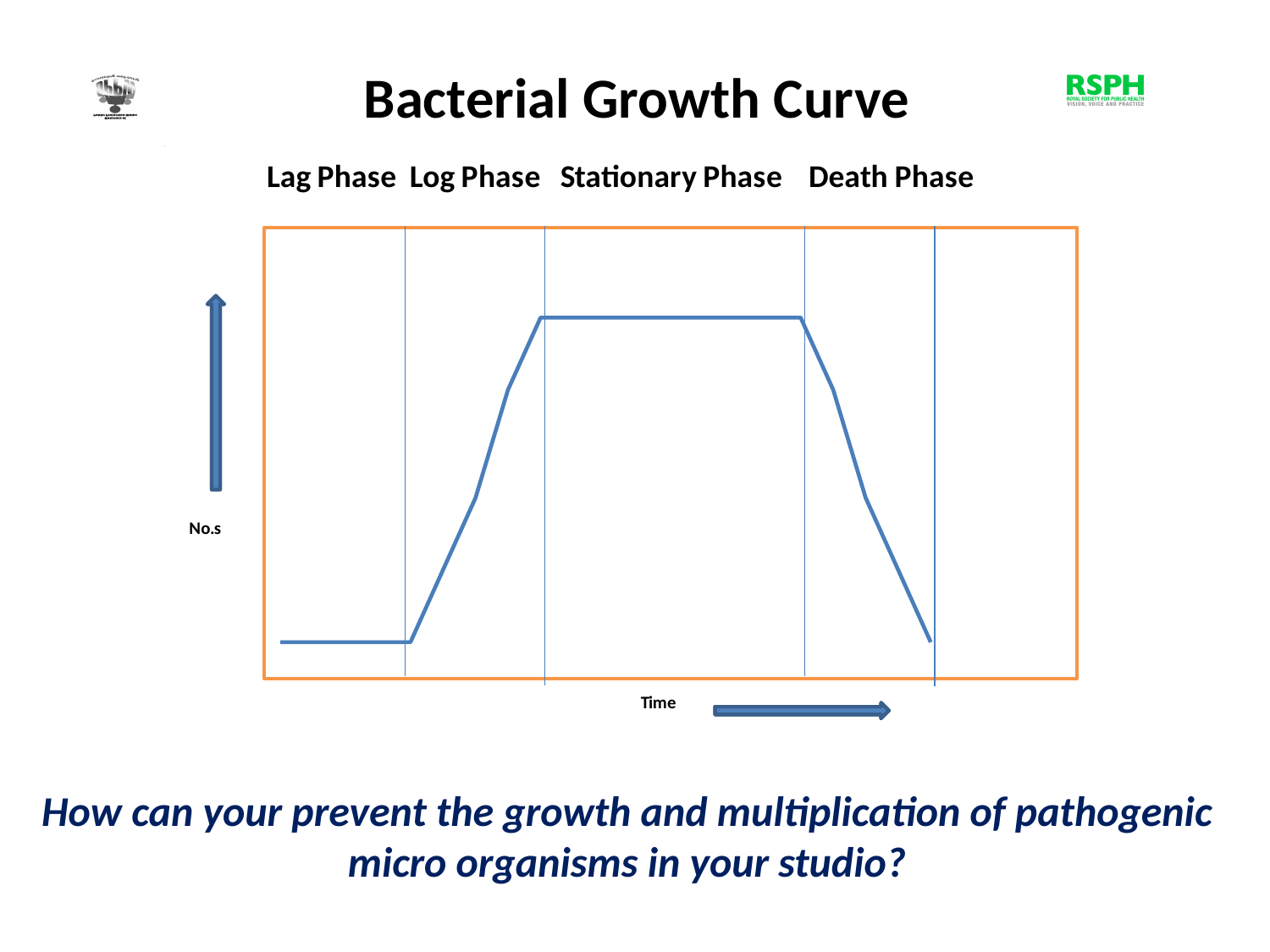
How many phases are labelled along the top of the chart? 4 Does the line rise, fall or stay flat during the Log Phase? Rise Which phase comes immediately after the Log Phase? Stationary Phase In which phase does the line reach its highest level? Stationary Phase Does the line rise, fall or stay flat during the Death Phase? Fall Does the line rise, fall or stay flat during the Stationary Phase? Stay flat What is the title of the chart? Bacterial Growth Curve Which phase is the first one shown along the time axis? Lag Phase What is the label on the vertical axis of the chart? No.s What kind of chart is shown on the slide? Line chart Is the line higher during the Stationary Phase or during the Lag Phase? Stationary Phase